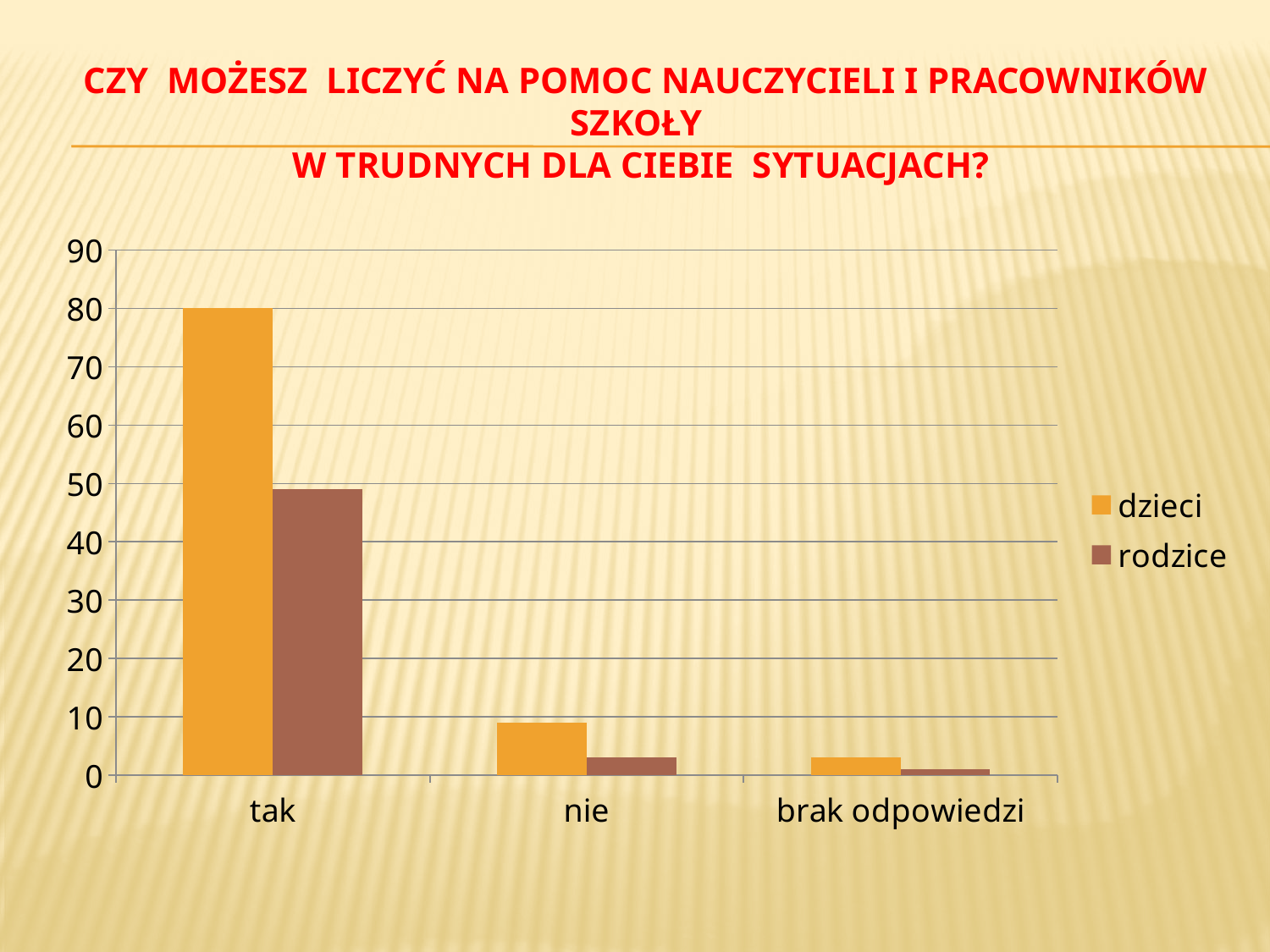
Which series is shown in orange in the legend? dzieci Which category has the highest value for dzieci? tak Is the value for rodzice in the tak category greater or less than 60? less What is the value for dzieci in the tak category? 80 Is the value for rodzice in the tak category greater or less than 40? greater How many series does the legend list? 2 Do the values for dzieci rise or fall from tak to brak odpowiedzi along the x axis? fall Is the value for dzieci in the nie category greater or less than 10? less How many categories are shown on the x axis? 3 Which category has the lowest value for rodzice? brak odpowiedzi In the tak category, which series has the larger value, dzieci or rodzice? dzieci What kind of chart is shown on the slide? bar chart